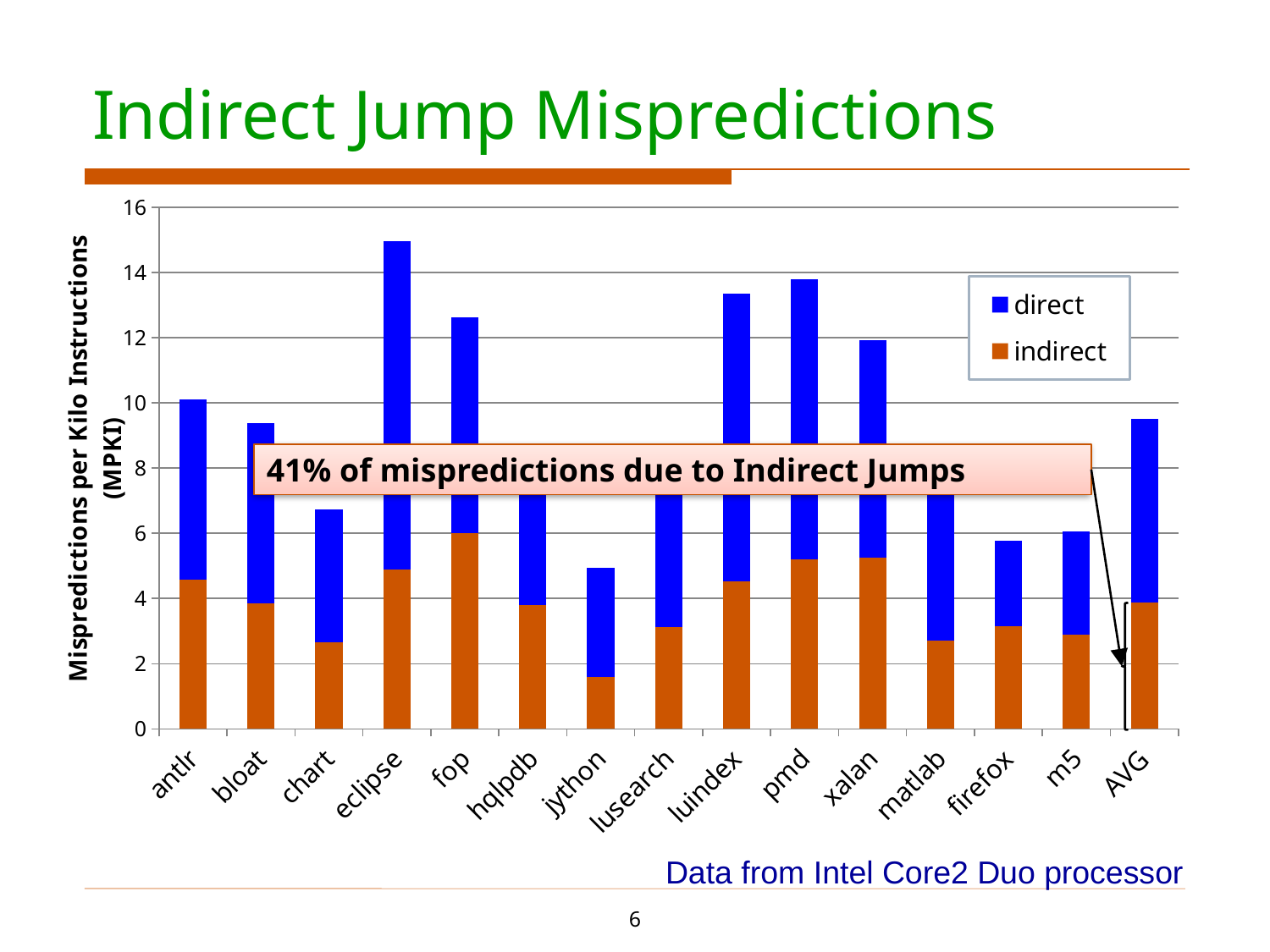
Which has a larger total value, pmd or xalan? pmd What kind of chart is shown on the slide? Stacked bar chart What is the title of the chart on the slide? Indirect Jump Mispredictions Which category has the highest total mispredictions per kilo instructions? eclipse Which has a larger indirect value, fop or jython? fop Which category has the lowest total mispredictions per kilo instructions? jython Is the total value for eclipse greater or less than 14? greater Which colour represents the indirect series in the chart? Orange How many series does the chart's legend list? 2 How many categories are shown along the x axis of the chart? 15 Is the total value for jython greater or less than 6? less Is the total value for AVG greater or less than 8? greater